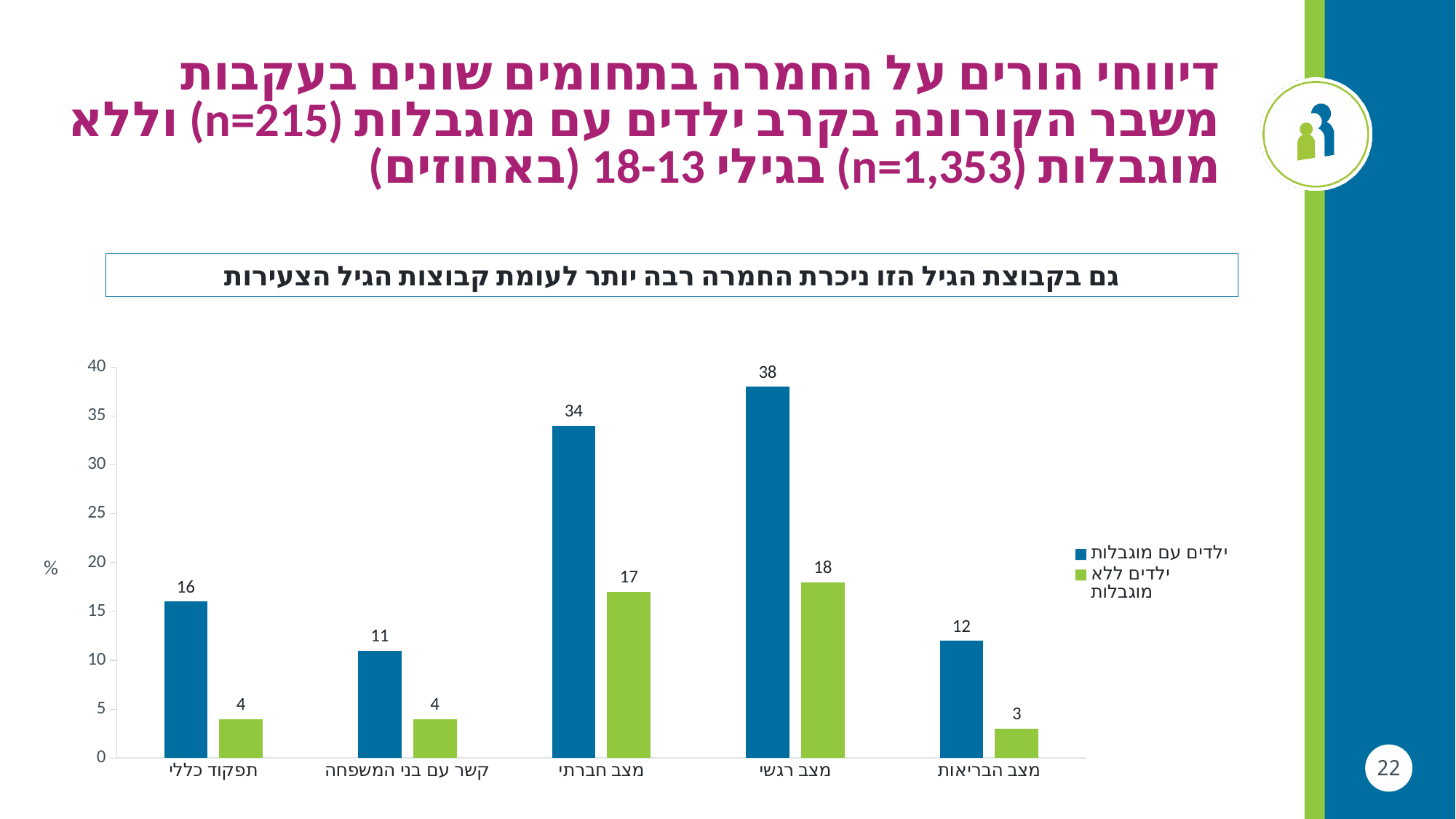
What kind of chart is shown on the slide? bar chart Which is larger in the מצב הבריאות category: ילדים עם מוגבלות or ילדים ללא מוגבלות? ילדים עם מוגבלות What is the value for ילדים עם מוגבלות in the מצב רגשי category? 38 What is the difference between ילדים עם מוגבלות and ילדים ללא מוגבלות in the מצב רגשי category? 20 Which category has the highest value for ילדים עם מוגבלות? מצב רגשי How many categories are shown on the x axis? 5 What colour are the bars for ילדים ללא מוגבלות? green Is the value for ילדים עם מוגבלות in מצב חברתי greater or less than 30? greater What is the value for ילדים עם מוגבלות in the תפקוד כללי category? 16 How many series does the legend list? 2 Which category has the lowest value for ילדים ללא מוגבלות? מצב הבריאות What is the value for ילדים ללא מוגבלות in the מצב חברתי category? 17